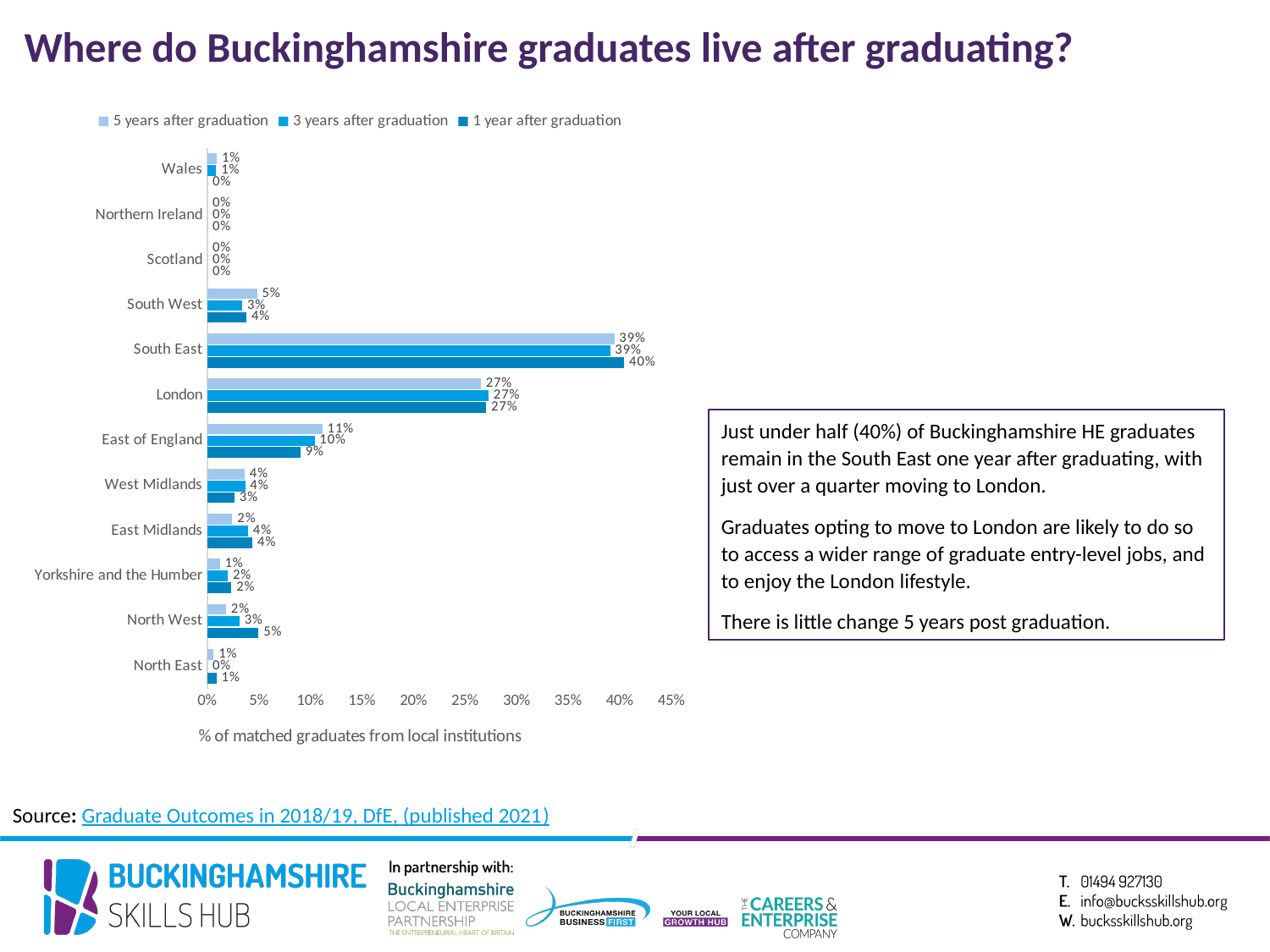
What is the value for North West 1 year after graduation? 5% What is the value for South East 1 year after graduation? 40% Which region has the highest value 1 year after graduation? South East What is the difference between the 5 years and 1 year after graduation values for North West? 3% What kind of chart is shown on the slide? Bar chart What is the difference between the South East and London values 1 year after graduation? 13% Which is larger for East of England: the value 5 years after graduation or 1 year after graduation? 5 years after graduation How many regions are shown on the chart? 12 What is the x-axis label of the chart? % of matched graduates from local institutions What is the value for East of England 3 years after graduation? 10% How many series does the legend list? 3 What is the value for London 5 years after graduation? 27%